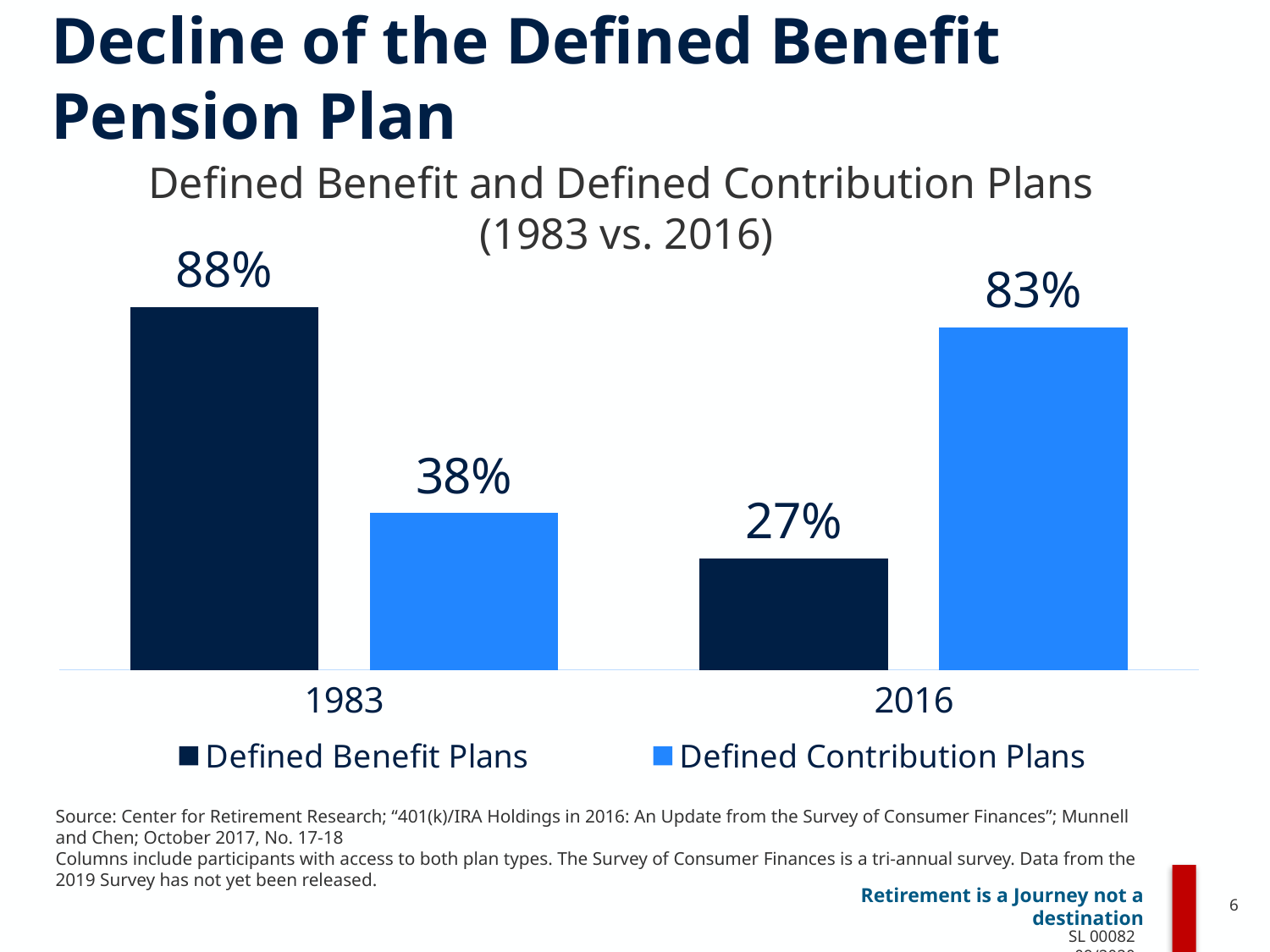
What is the value for Defined Contribution Plans in 1983? 38% Which year has the lowest value for Defined Contribution Plans? 1983 Which year has the highest value for Defined Benefit Plans? 1983 What is the value for Defined Contribution Plans in 2016? 83% Do the Defined Benefit Plans values rise or fall from 1983 to 2016? Fall What is the value for Defined Benefit Plans in 2016? 27% What is the difference between the Defined Benefit Plans values for 1983 and 2016? 61% What is the difference between Defined Contribution Plans and Defined Benefit Plans in 2016? 56% What is the value for Defined Benefit Plans in 1983? 88% What kind of chart is shown on the slide? Bar chart How many series does the legend list? 2 In 1983, which is larger: Defined Benefit Plans or Defined Contribution Plans? Defined Benefit Plans